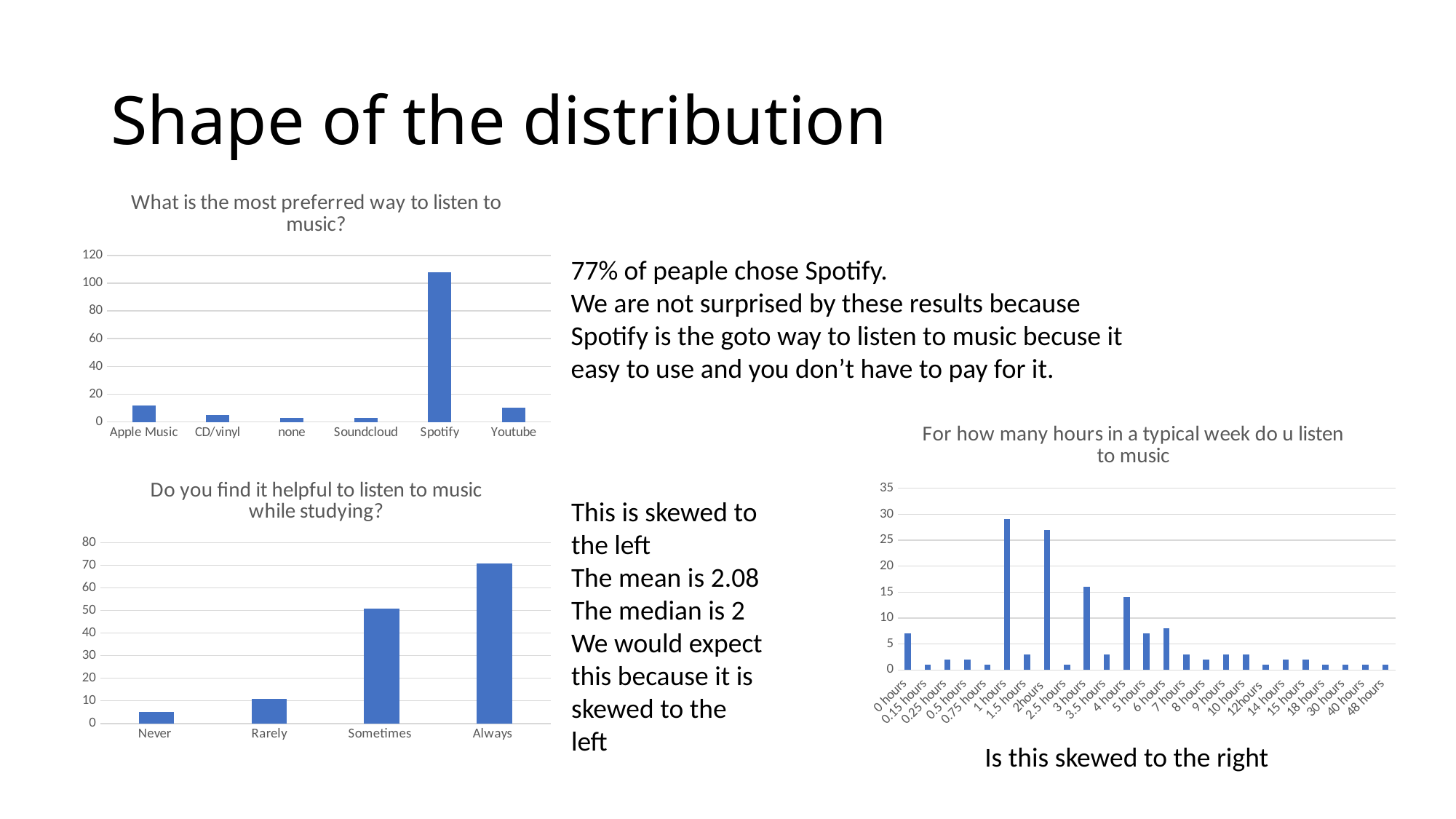
In the chart titled "What is the most preferred way to listen to music?", is the value for Spotify greater or less than 100? greater In the chart titled "For how many hours in a typical week do u listen to music", is the value for 1 hours greater or less than 25? greater How many categories are shown in the chart titled "What is the most preferred way to listen to music?"? 6 In the chart titled "Do you find it helpful to listen to music while studying?", is the value for Sometimes greater or less than 40? greater What kind of chart is the one titled "Do you find it helpful to listen to music while studying?"? bar chart In the chart titled "What is the most preferred way to listen to music?", which category has the highest value? Spotify In the chart titled "Do you find it helpful to listen to music while studying?", do the values rise or fall from Never to Always? rise How many categories are shown on the x axis of the chart titled "For how many hours in a typical week do u listen to music"? 25 In the chart titled "Do you find it helpful to listen to music while studying?", which category has the highest value? Always In the chart titled "Do you find it helpful to listen to music while studying?", which category has the lowest value? Never In the chart titled "For how many hours in a typical week do u listen to music", which is larger, the value for 1 hours or the value for 3 hours? 1 hours